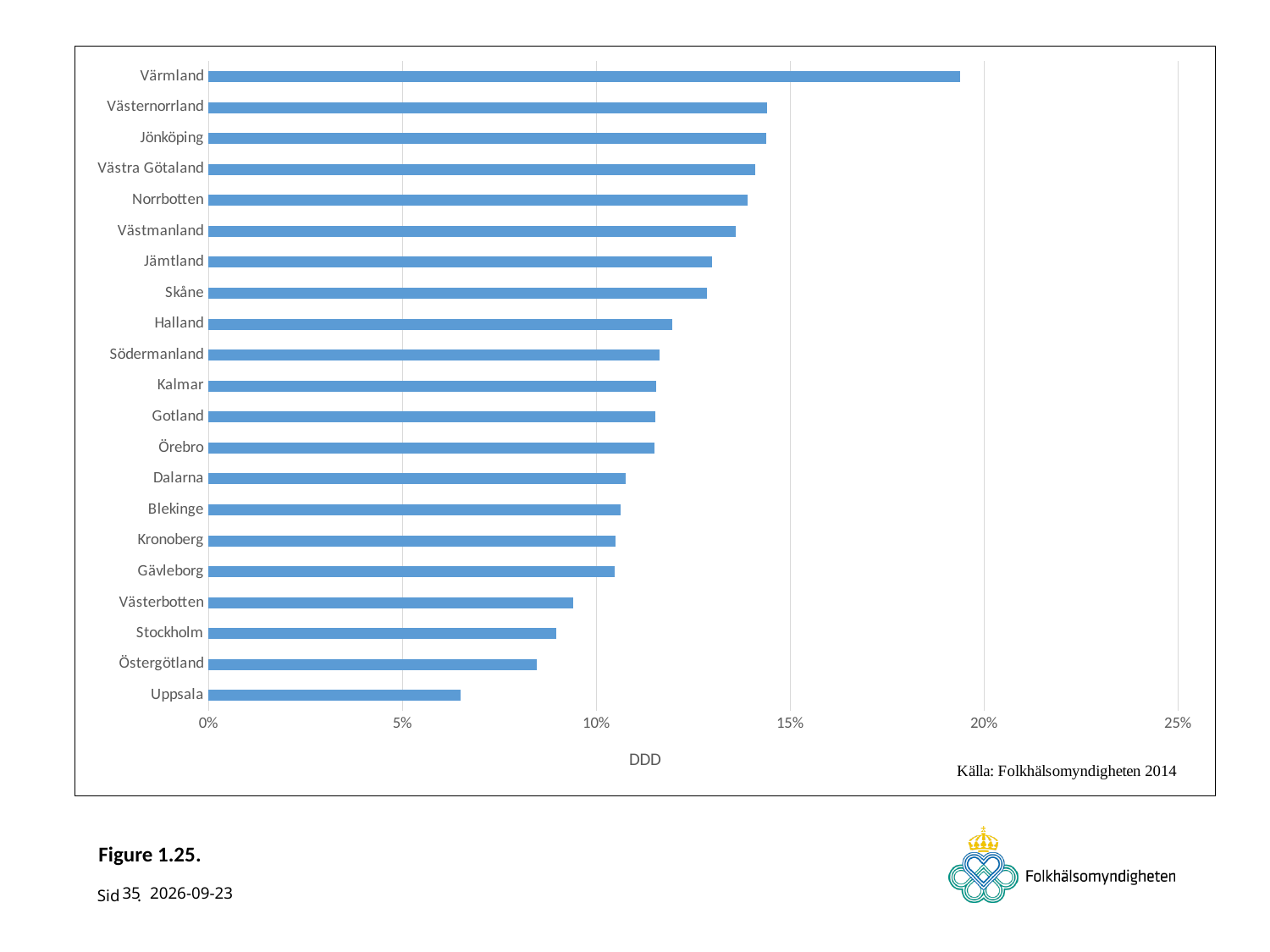
Is the value for Stockholm greater or less than 10%? less Is the value for Halland greater or less than 10%? greater Is the value for Värmland greater or less than 15%? greater Which region has the highest value? Värmland What is the label shown on the horizontal axis of the chart? DDD What kind of chart is shown on the slide? bar chart Which has a larger value, Halland or Stockholm? Halland Which region has the lowest value? Uppsala How many regions are plotted in the chart? 21 Which has a larger value, Östergötland or Jämtland? Jämtland